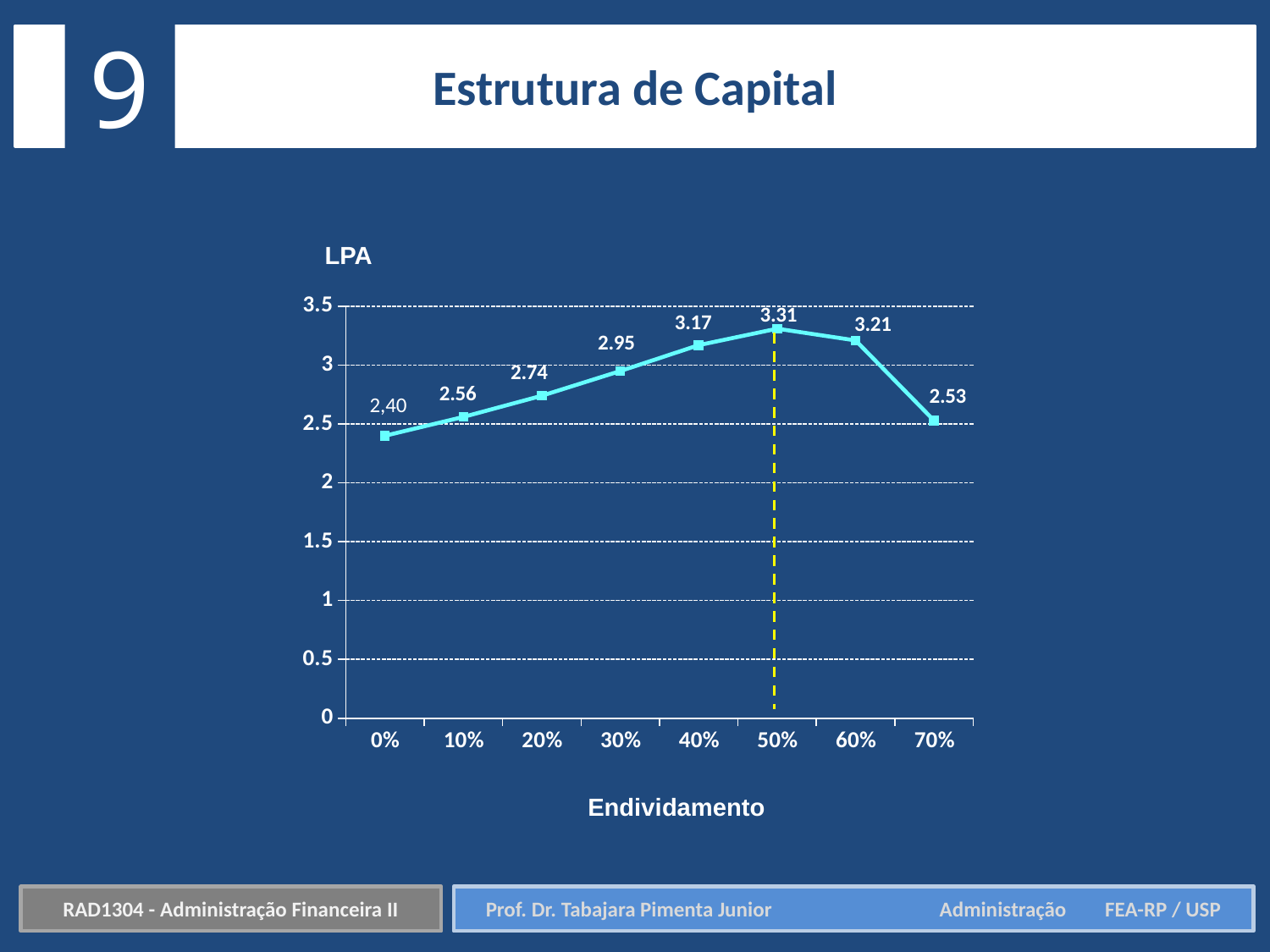
What is the difference between the LPA at 50% and the LPA at 60%? 0.10 Is the LPA value at 30% greater or less than 3? less At which Endividamento level is LPA highest? 50% What is the LPA value at 20% Endividamento? 2.74 What is the label of the x axis of the chart? Endividamento What is the LPA value at 70% Endividamento? 2.53 What is the LPA value at 50% Endividamento? 3.31 What kind of chart is shown on the slide? line chart Which is larger, the LPA at 60% or the LPA at 70%? 60% What is the difference between the LPA at 40% and the LPA at 30%? 0.22 How many Endividamento levels are plotted on the chart? 8 At which Endividamento level is LPA lowest? 0%